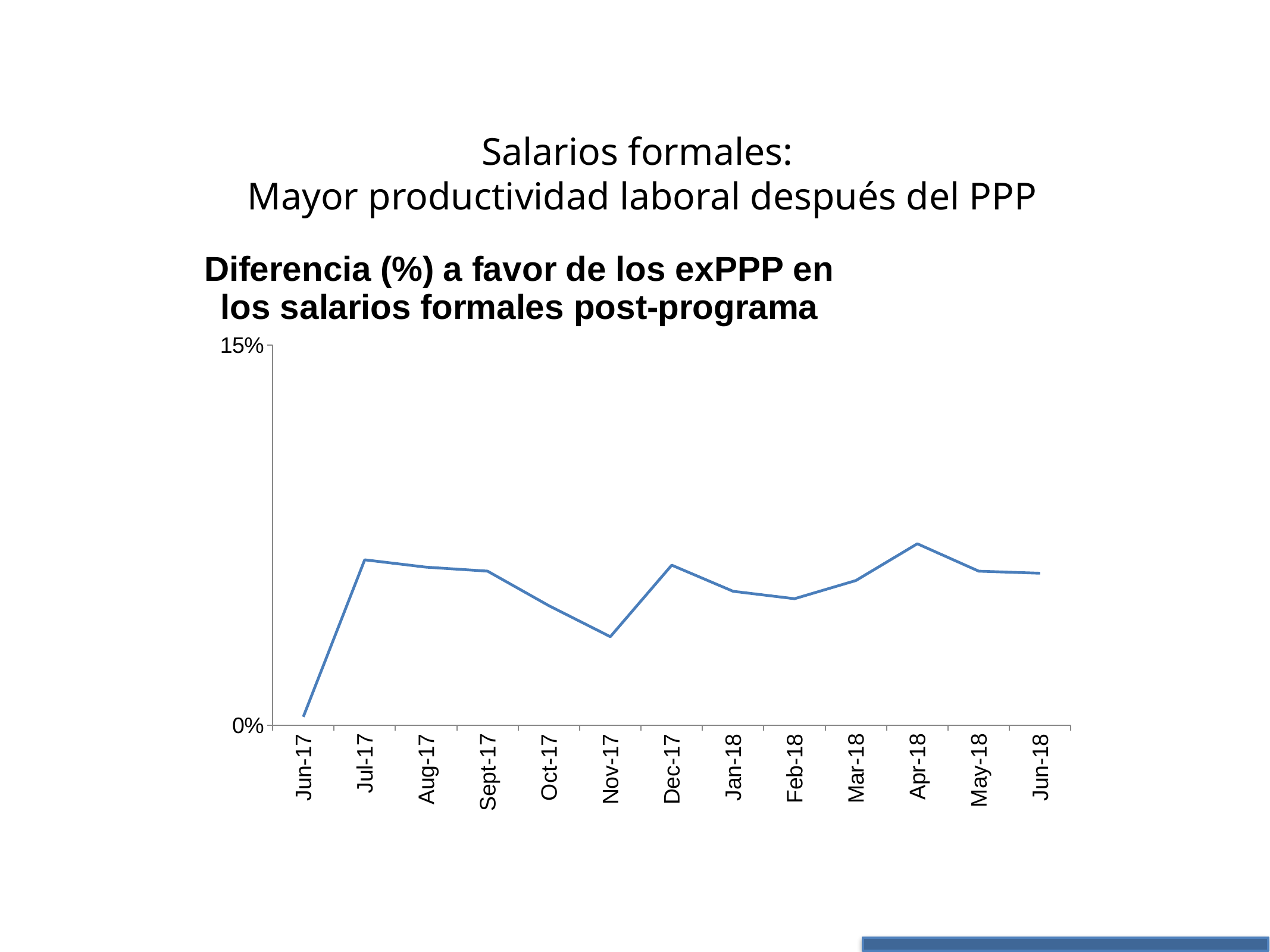
What is the highest value shown on the y axis? 15% What is the title of the chart? Diferencia (%) a favor de los exPPP en los salarios formales post-programa Is the value for Apr-18 greater or less than 15%? less Which is larger, the value for Jul-17 or the value for Nov-17? Jul-17 Which month has the highest value? Apr-18 Do the values rise or fall from Sept-17 to Nov-17? fall How many months are plotted along the x axis? 13 Which is larger, the value for Apr-18 or the value for Feb-18? Apr-18 What kind of chart is shown on the slide? line chart Do the values rise or fall from Feb-18 to Apr-18? rise Do the values rise or fall from Jun-17 to Jul-17? rise Which month has the lowest value? Jun-17